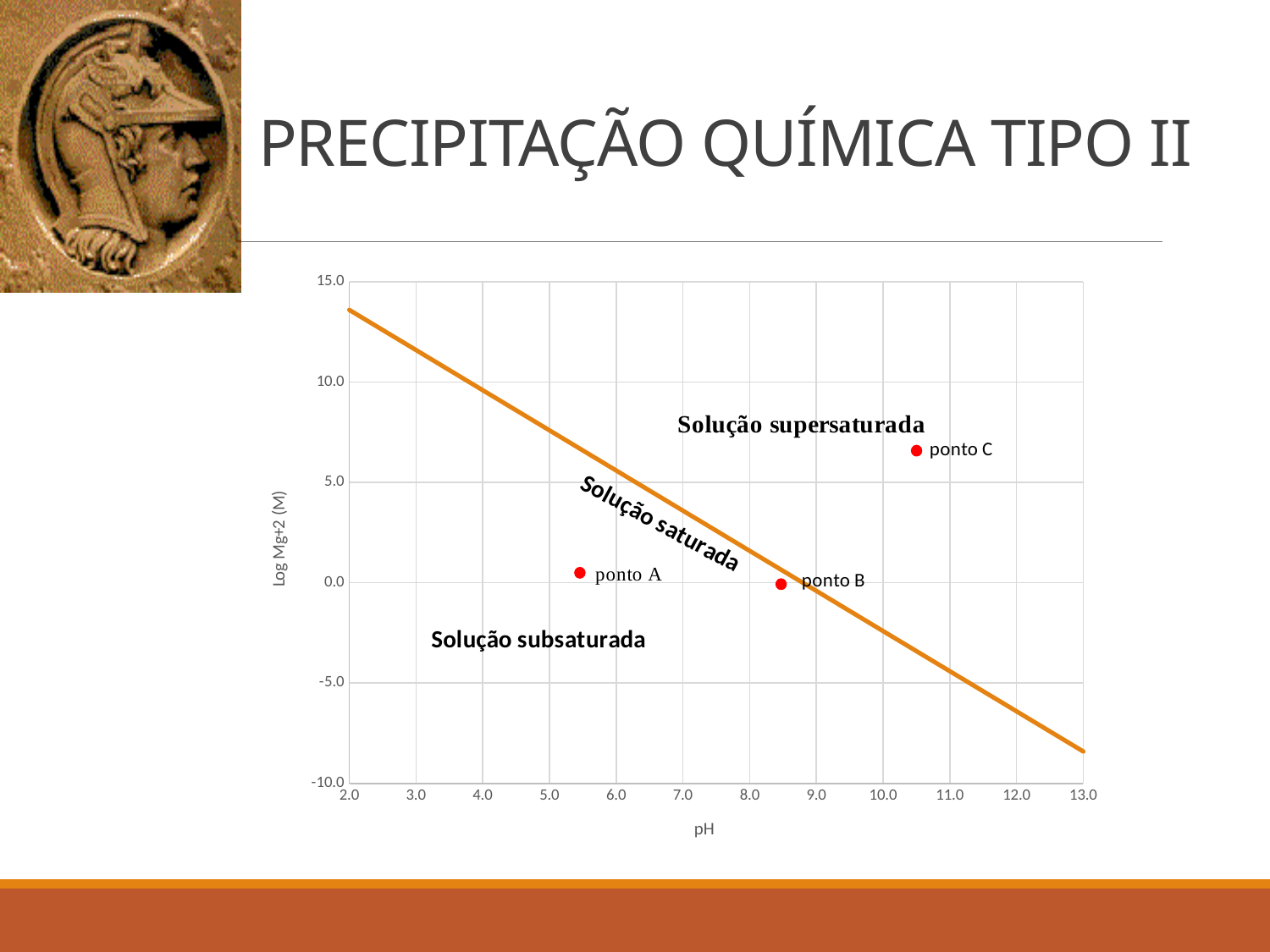
Which has a higher Log Mg+2 value, ponto C or ponto A? ponto C Is the pH of ponto C greater or less than 10.0? greater What is the label of the y axis? Log Mg+2 (M) Is the Log Mg+2 value for ponto C greater or less than 5.0? greater Does the orange line rise or fall as pH increases? fall Is the pH of ponto A greater or less than 6.0? less What is the label of the x axis? pH Which labelled point has the highest Log Mg+2 value? ponto C How many labelled red points are plotted on the chart? 3 What kind of chart is shown on the slide? line chart